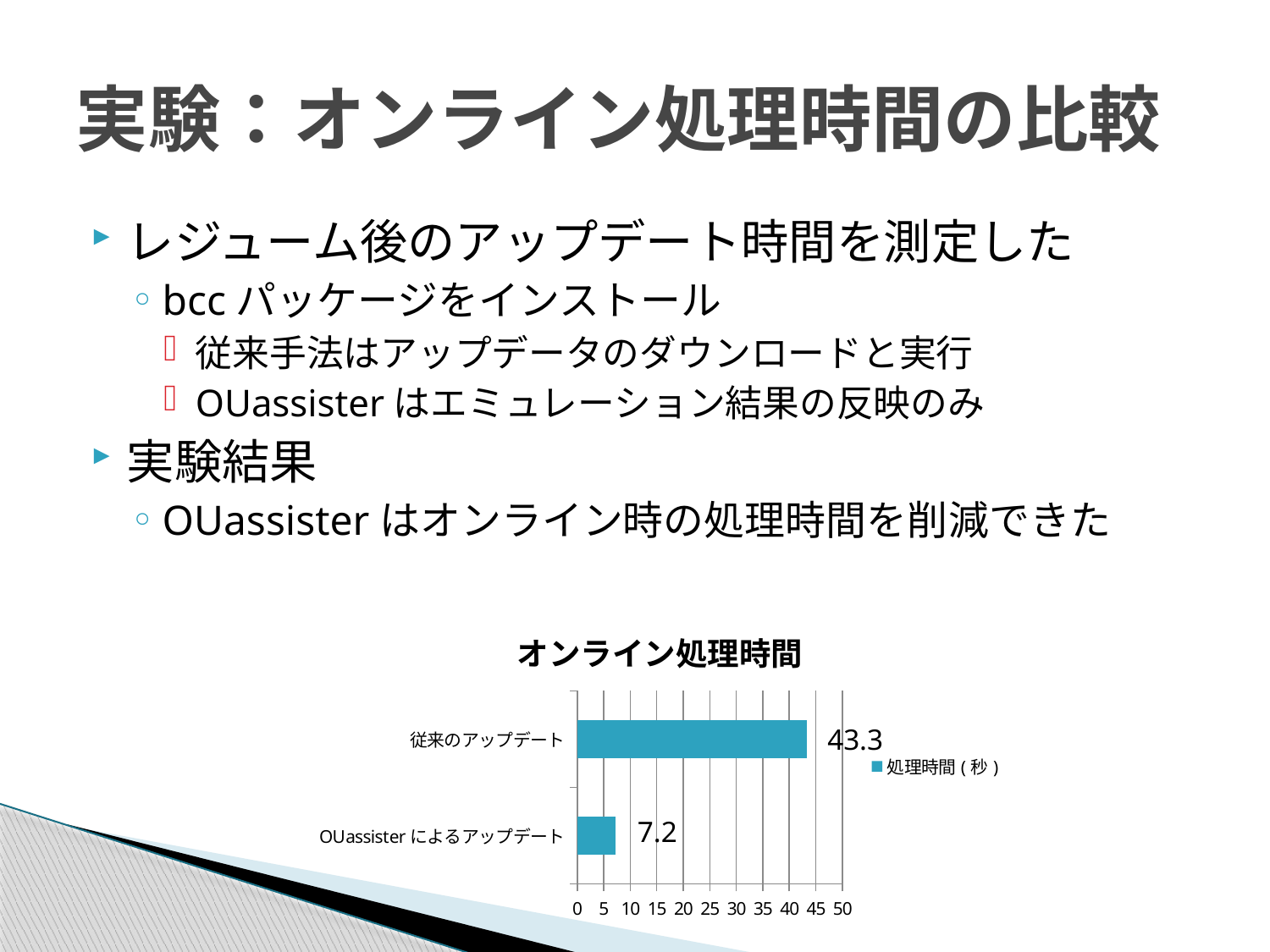
How many series does the legend of the オンライン処理時間 chart list? 1 What is the value for 従来のアップデート in the オンライン処理時間 chart? 43.3 Is the value for OUassister によるアップデート greater or less than 10 in the オンライン処理時間 chart? less Which category has the highest value in the オンライン処理時間 chart? 従来のアップデート What is the legend entry in the オンライン処理時間 chart? 処理時間 ( 秒 ) What is the difference between the values for 従来のアップデート and OUassister によるアップデート in the オンライン処理時間 chart? 36.1 Is the value for 従来のアップデート greater or less than 40 in the オンライン処理時間 chart? greater How many categories are shown in the オンライン処理時間 chart? 2 What is the value for OUassister によるアップデート in the オンライン処理時間 chart? 7.2 Which is larger in the オンライン処理時間 chart: the value for 従来のアップデート or for OUassister によるアップデート? 従来のアップデート What kind of chart is the オンライン処理時間 chart? bar chart Which category has the lowest value in the オンライン処理時間 chart? OUassister によるアップデート